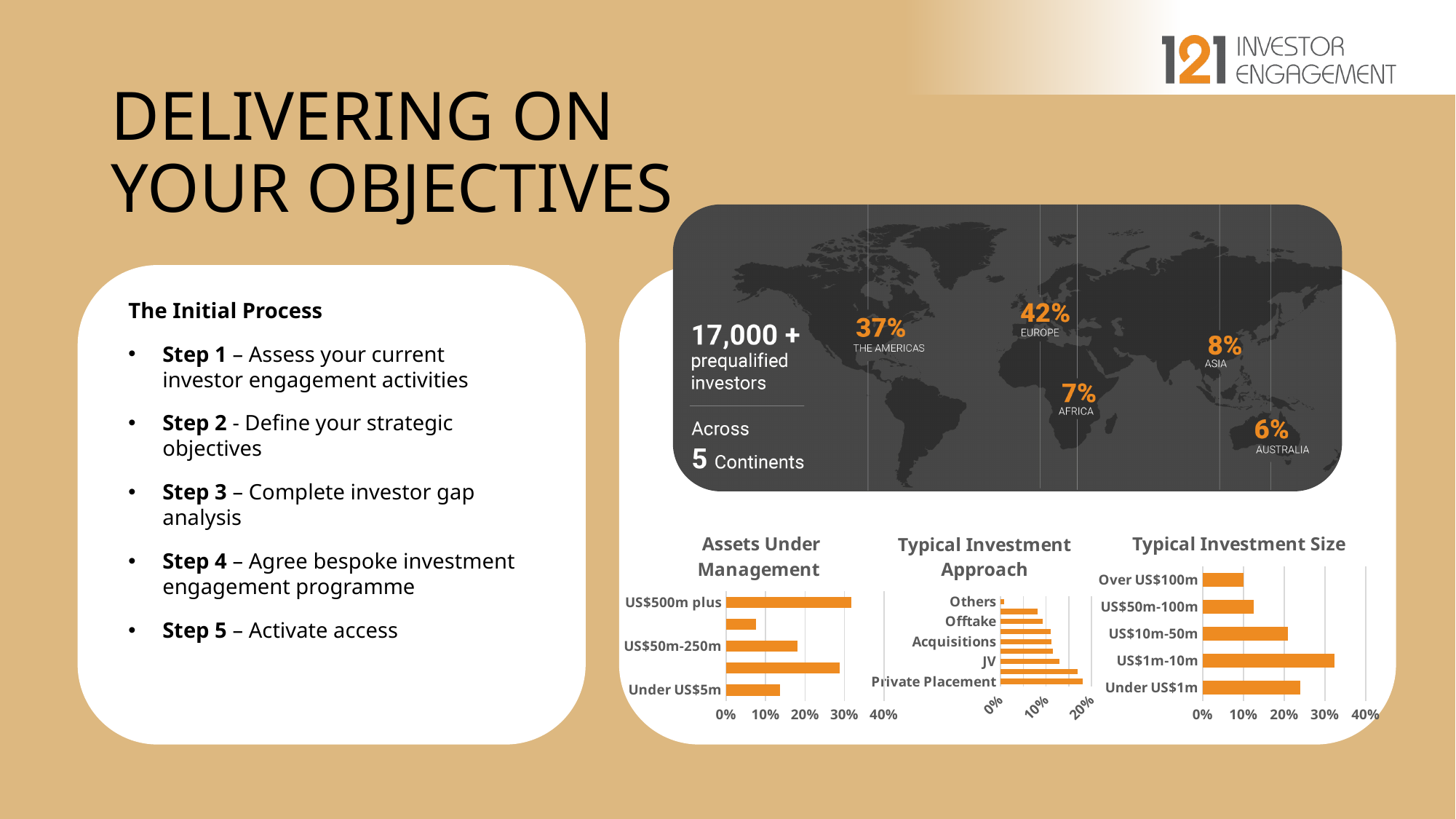
In the "Assets Under Management" chart, which is larger, the value for US$500m plus or the value for Under US$5m? US$500m plus In the "Typical Investment Size" chart, which category has the highest value? US$1m-10m In the "Typical Investment Approach" chart, which labelled category has the highest value? Private Placement How many categories are shown in the "Typical Investment Size" chart? 5 In the "Typical Investment Size" chart, is the value for US$1m-10m greater or less than 30%? greater In the "Assets Under Management" chart, is the value for US$500m plus greater or less than 30%? greater What is the title of the leftmost bar chart at the bottom of the slide? Assets Under Management In the "Typical Investment Size" chart, which category has the lowest value? Over US$100m In the "Typical Investment Approach" chart, which labelled category has the lowest value? Others What kind of chart is the "Typical Investment Size" chart? Bar chart In the "Typical Investment Approach" chart, is the value for Private Placement greater or less than 10%? greater